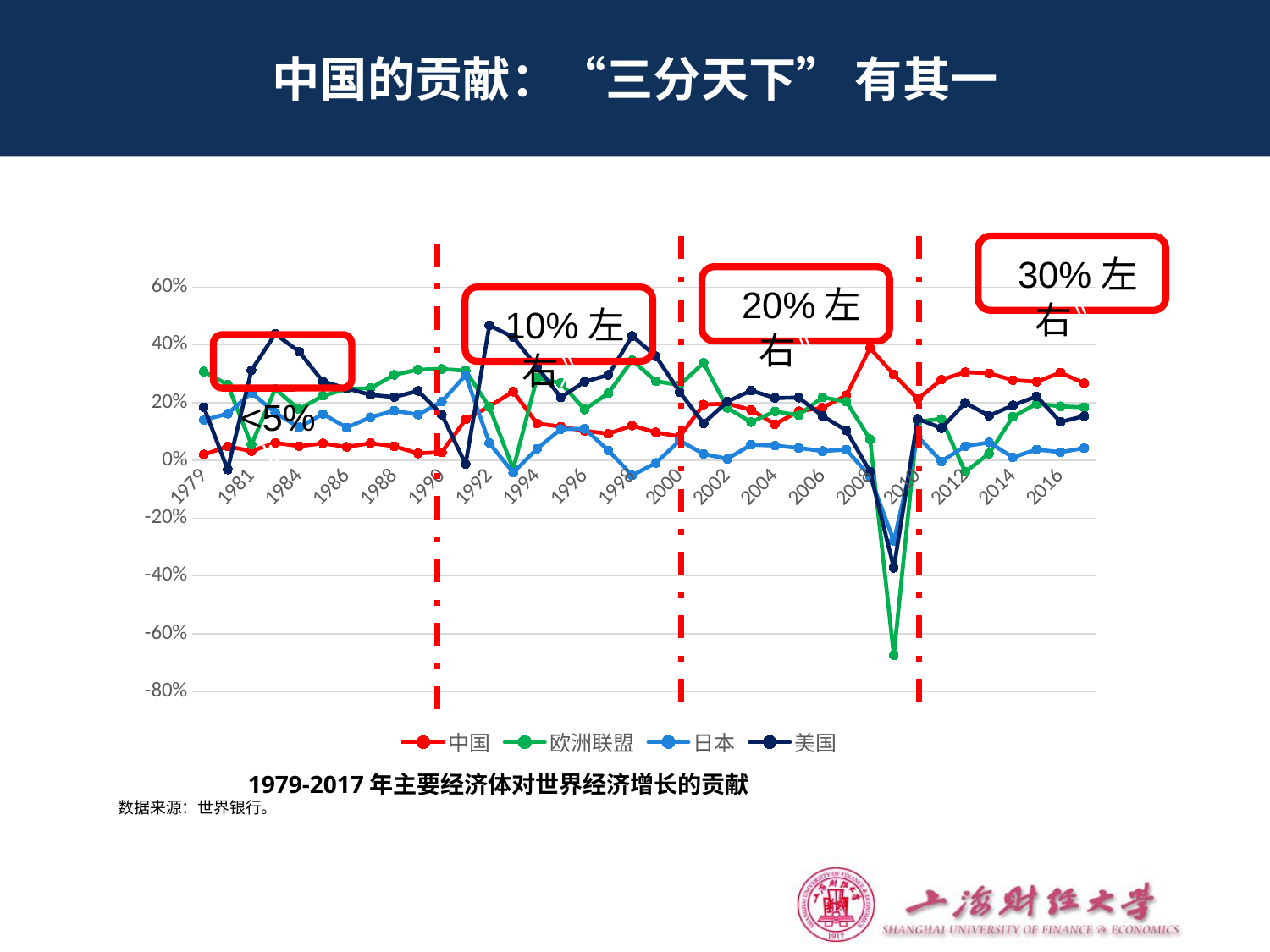
What are the series listed in the legend? 中国, 欧洲联盟, 日本, 美国 Is the value for 中国 in 2008 greater or less than 20%? greater What kind of chart is shown on the slide? line chart Does the value for 中国 generally rise or fall from 1979 to 2017? rise Is the value for 欧洲联盟 in 2009 greater or less than -60%? less Which is larger in 2016, the value for 中国 or the value for 日本? 中国 Which series has the lowest value in 2009? 欧洲联盟 Which series has the highest value in 2016? 中国 Is the value for 美国 in 2009 greater or less than -20%? less What is the title of the chart? 1979-2017 年主要经济体对世界经济增长的贡献 How many series does the legend list? 4